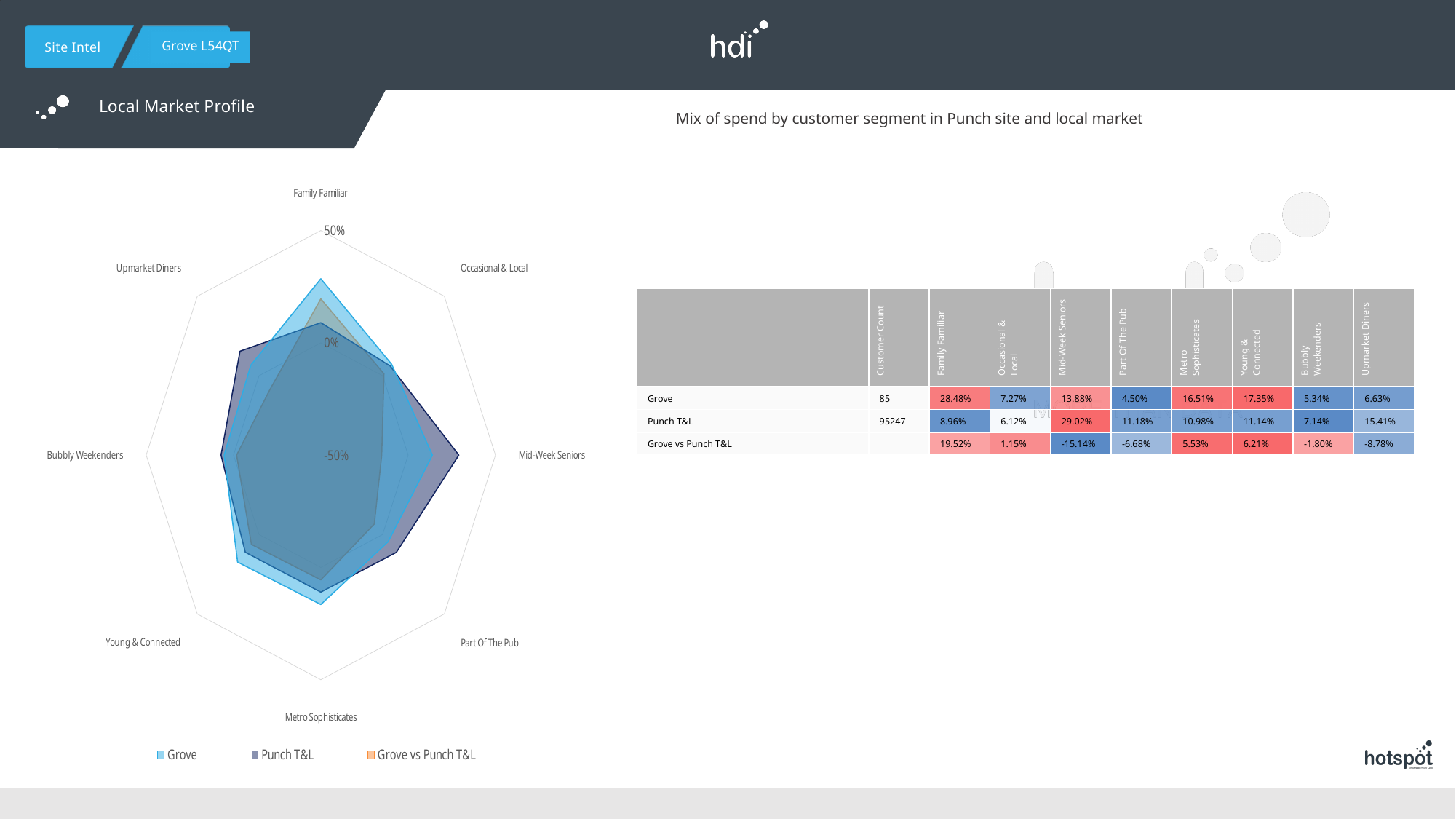
Is the Grove value for Family Familiar greater or less than 0% on the radar axis? greater How many series does the radar chart's legend list? 3 Which segment has the highest Grove value? Family Familiar What is the title shown above the table on the slide? Mix of spend by customer segment in Punch site and local market Which is larger for Metro Sophisticates, the Grove value or the Punch T&L value? Grove What kind of chart is shown on the left of the slide? Radar chart What is the Grove vs Punch T&L value for Upmarket Diners? -8.78% What is the Grove value for Family Familiar? 28.48% What is the Punch T&L value for Mid-Week Seniors? 29.02% Which segment has the lowest Grove value? Part Of The Pub How many customer segments are plotted around the radar chart? 8 Which segment has the highest Punch T&L value? Mid-Week Seniors